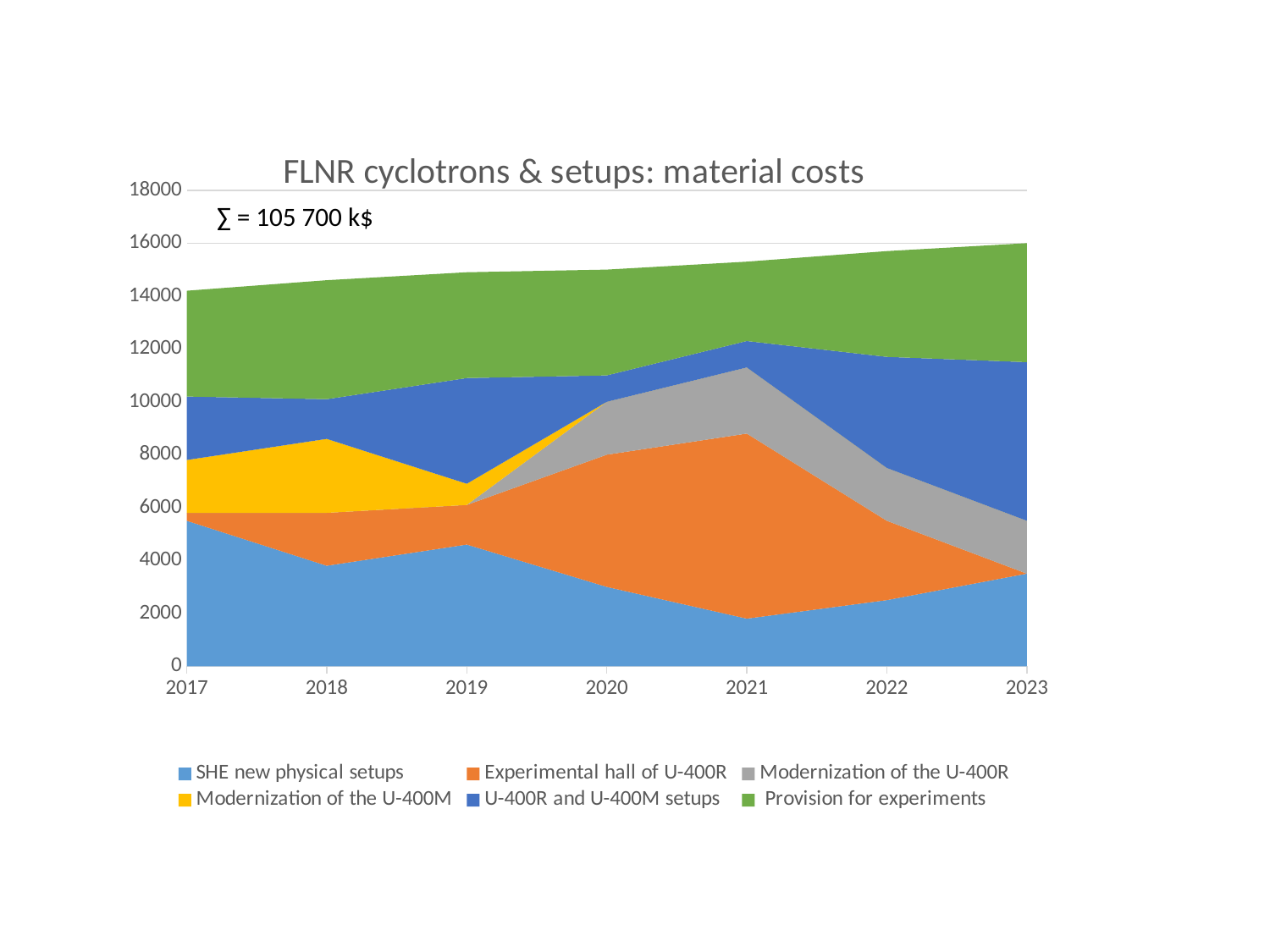
Is the value for SHE new physical setups in 2017 greater or less than 4000? greater Does the total stacked value rise or fall from 2017 to 2023? rise Which year has the highest total stacked value? 2023 Is the value for SHE new physical setups in 2021 greater or less than 4000? less What is the title of the chart? FLNR cyclotrons & setups: material costs How many years are shown along the x axis? 7 Which year has the lowest total stacked value? 2017 What total sum is annotated on the chart? ∑ = 105 700 k$ What kind of chart is shown on the slide? stacked area chart Is the total stacked value for 2020 greater or less than 14000? greater How many series does the legend list? 6 Which is larger for SHE new physical setups: the value in 2017 or the value in 2021? 2017